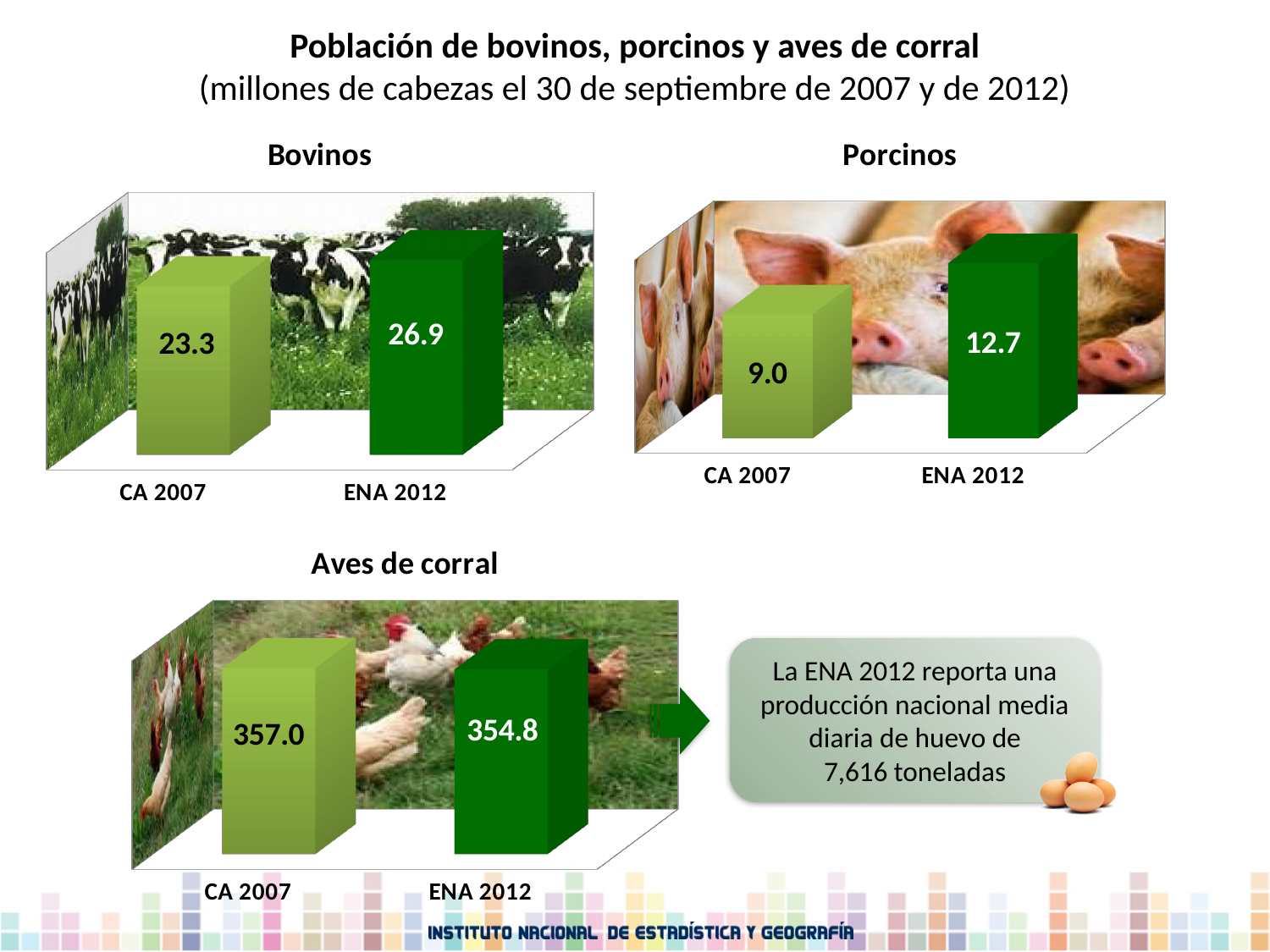
In the Aves de corral chart, what is the value for ENA 2012? 354.8 In the Bovinos chart, which is larger, the value for CA 2007 or ENA 2012? ENA 2012 In the Bovinos chart, what is the value for CA 2007? 23.3 In the Porcinos chart, what is the value for CA 2007? 9.0 In the Bovinos chart, which category has the lowest value? CA 2007 In the Aves de corral chart, what is the difference between the CA 2007 and ENA 2012 values? 2.2 In the Porcinos chart, what is the value for ENA 2012? 12.7 In the Aves de corral chart, which category has the highest value? CA 2007 What kind of chart is the Aves de corral chart? Bar chart In the Porcinos chart, what is the difference between the ENA 2012 and CA 2007 values? 3.7 How many categories does the Porcinos chart show? 2 In the Bovinos chart, what is the value for ENA 2012? 26.9